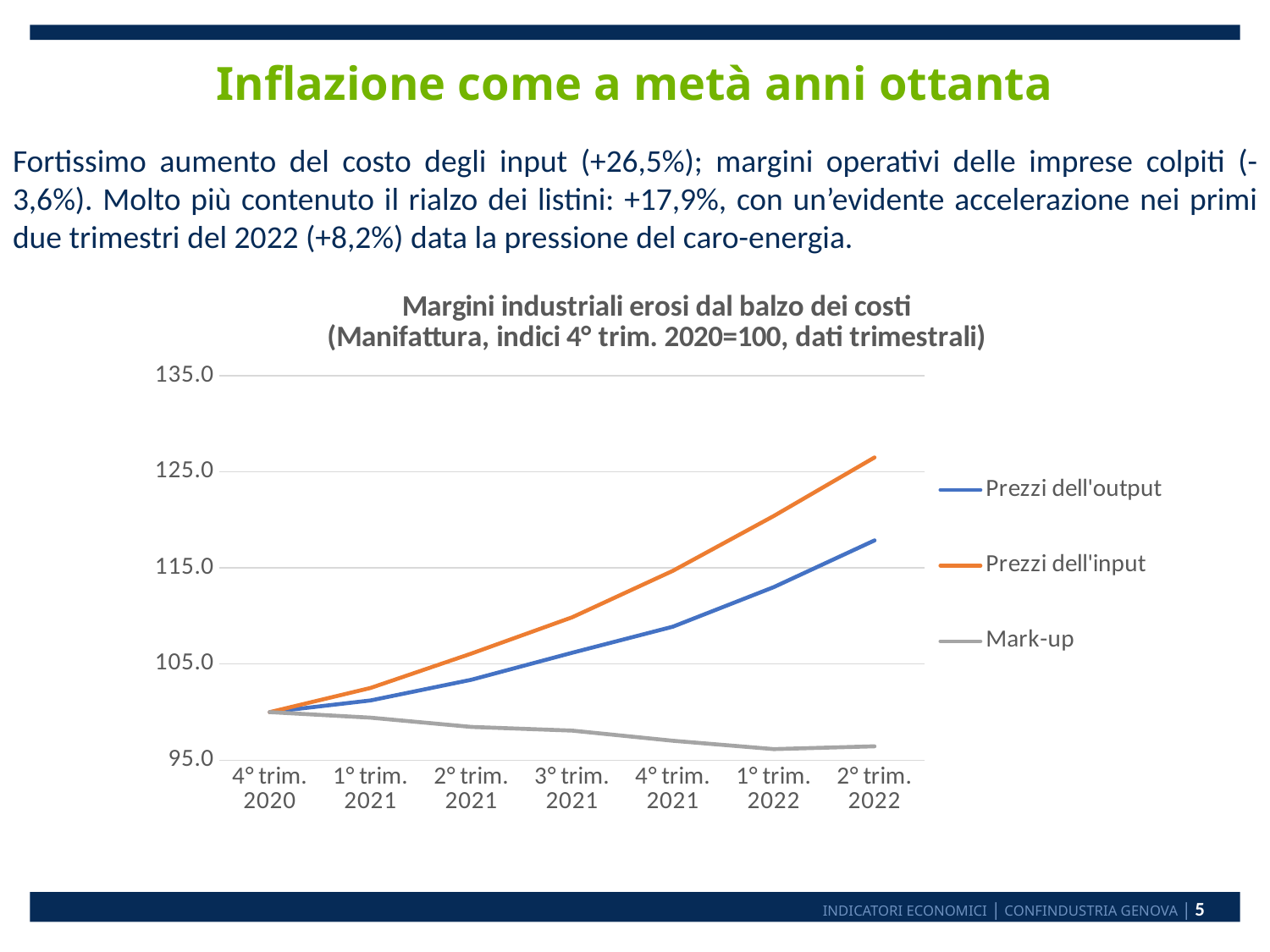
Is the value for Mark-up at 1° trim. 2022 greater or less than 105? less What kind of chart is shown on the slide? Line chart Which series is highest at 2° trim. 2022? Prezzi dell'input Is the value for Prezzi dell'output at 2° trim. 2022 greater or less than 115? greater Which series is lowest at 2° trim. 2022? Mark-up How many series does the chart legend list? 3 Is the value for Prezzi dell'input at 4° trim. 2021 greater or less than 105? greater Does the Prezzi dell'input series rise or fall from 4° trim. 2020 to 2° trim. 2022? Rise At 2° trim. 2022, which is larger: Prezzi dell'input or Prezzi dell'output? Prezzi dell'input What is the title of the chart? Margini industriali erosi dal balzo dei costi (Manifattura, indici 4° trim. 2020=100, dati trimestrali) Does the Mark-up series rise or fall from 4° trim. 2020 to 1° trim. 2022? Fall How many quarters are plotted along the x axis of the chart? 7